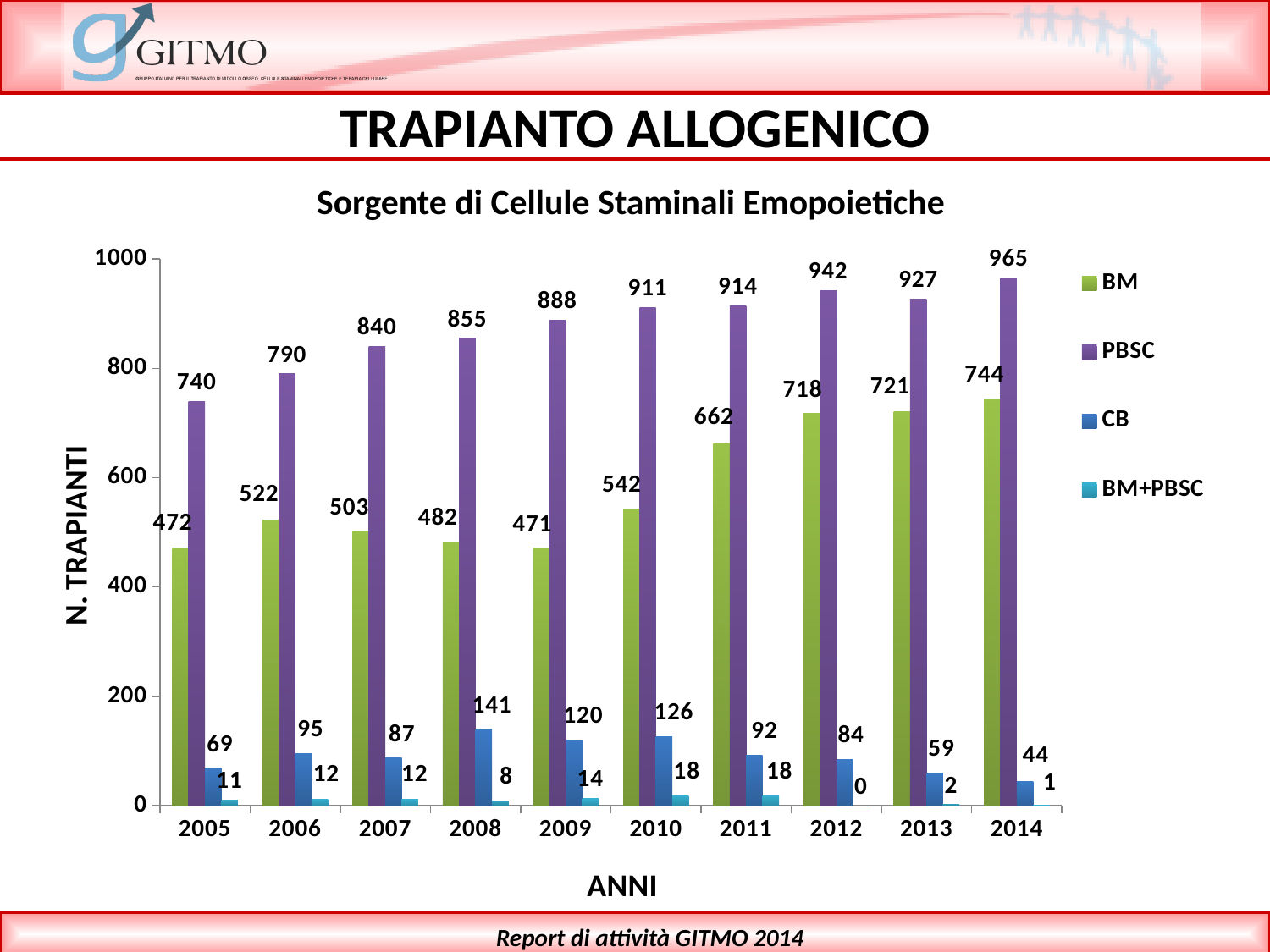
What is the BM+PBSC value for 2010? 18 Which is larger, the BM value in 2012 or the BM value in 2013? 2013 How many years are shown on the x axis? 10 Does the PBSC value rise or fall from 2005 to 2014? rise What kind of chart is shown on the slide? bar chart What is the difference between the PBSC and BM values in 2005? 268 What is the BM value for 2009? 471 What is the CB value for 2008? 141 In which year is the PBSC value highest? 2014 In which year is the CB value lowest? 2014 What is the PBSC value for 2014? 965 How many series does the legend list? 4